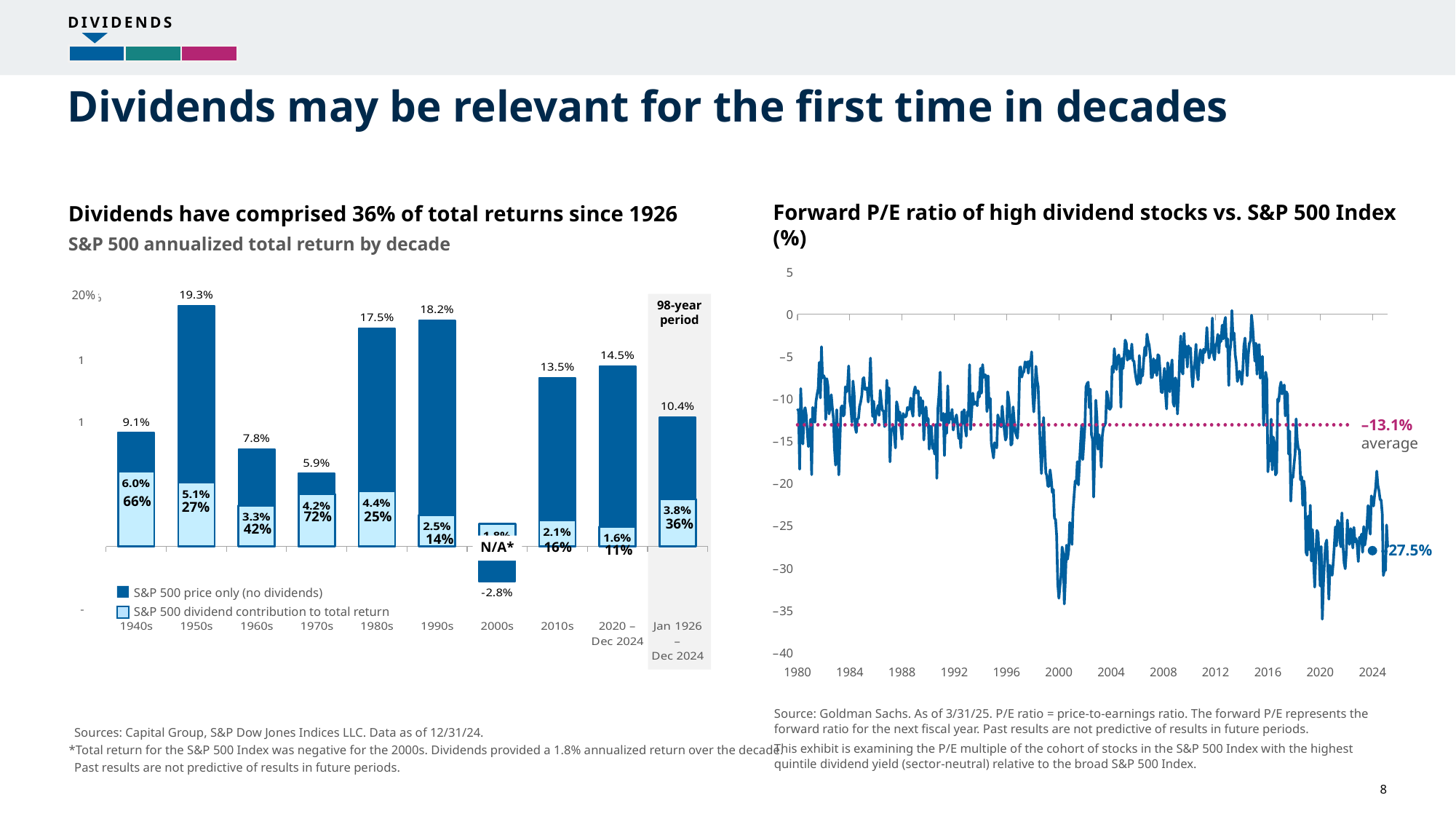
In the left chart, what is the difference between the total returns of the 1990s and the 1980s? 0.7 percentage points In the left chart, which period had the lowest annualized total return? 2000s In the right chart, what is the average forward P/E ratio of high dividend stocks vs. the S&P 500 Index shown by the dotted line? –13.1% In the left chart, which period had a higher total return: the 2010s or 2020–Dec 2024? 2020–Dec 2024 What kind of chart is the left chart? Bar chart In the left chart, what was the dividend contribution to total return in the 1940s? 6.0% In the left chart, what was the annualized total return for the 98-year period Jan 1926–Dec 2024? 10.4% How many series does the legend of the left chart list? 2 In the left chart, which decade had the highest annualized total return? 1950s In the left chart, what was the S&P 500 annualized total return for the 1950s? 19.3% In the left chart, what share of total return did dividends provide in the 1970s? 72% In the right chart, what is the most recent value labeled at the end of the line? –27.5%